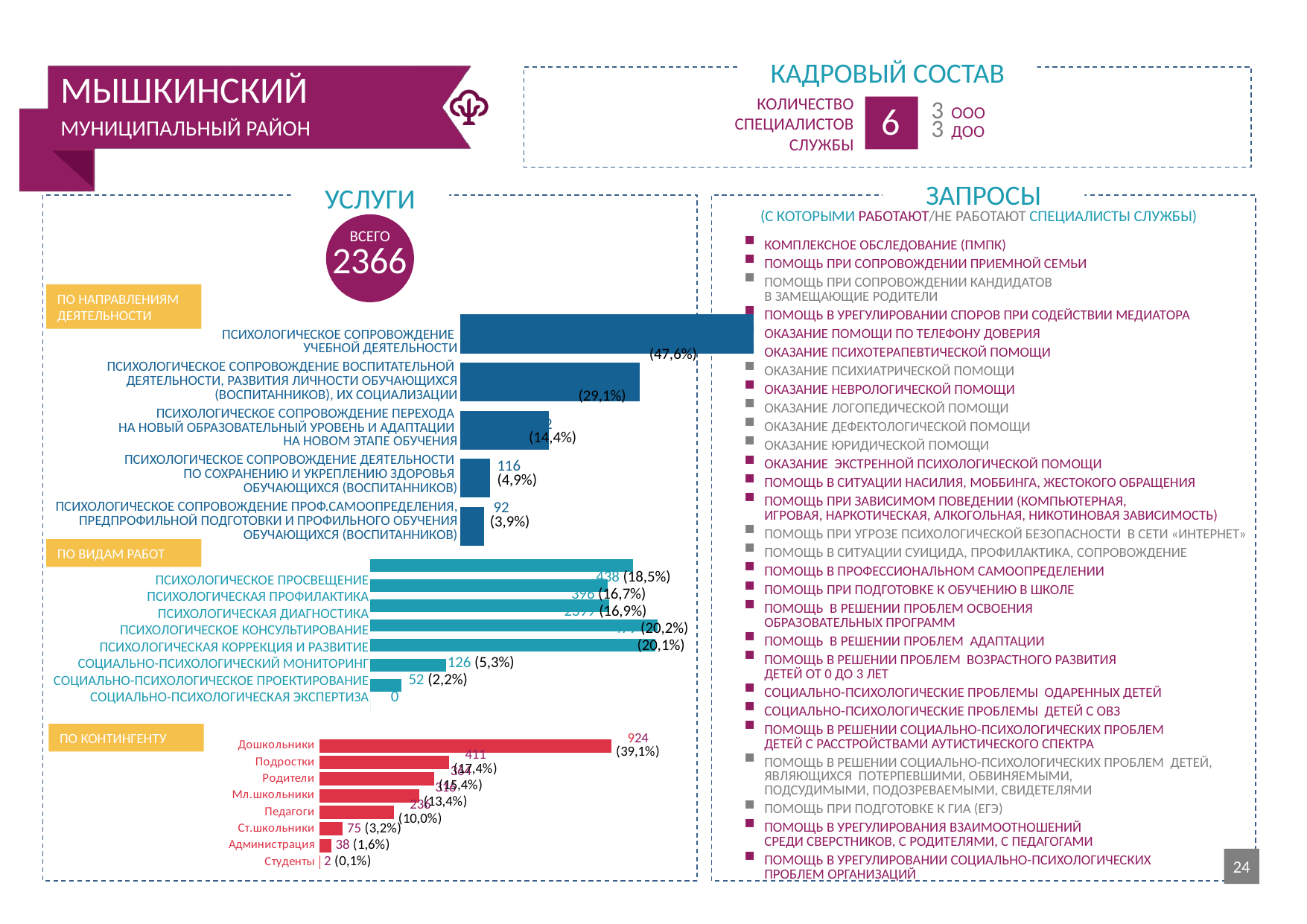
In the 'По видам работ' chart, which category has the lowest value? Социально-психологическая экспертиза In the 'По видам работ' chart, what is the value for Социально-психологический мониторинг? 126 In the 'По контингенту' chart, which category has the lowest value? Студенты In the 'По контингенту' chart, which category has the highest value? Дошкольники How many categories are shown in the 'По контингенту' chart? 8 What kind of chart is the 'По контингенту' chart? bar chart In the 'По контингенту' chart, what is the value for Дошкольники? 924 In the 'По контингенту' chart, what percentage is shown for Дошкольники? 39,1% In the 'По контингенту' chart, what is the difference between Ст.школьники and Администрация? 37 In the 'По видам работ' chart, which is larger: Психологическое просвещение or Психологическая профилактика? Психологическое просвещение In the 'По контингенту' chart, what is the value for Администрация? 38 In the 'По направлениям деятельности' chart, what is the difference between the value for психологическое сопровождение деятельности по сохранению и укреплению здоровья (116) and психологическое сопровождение проф.самоопределения (92)? 24